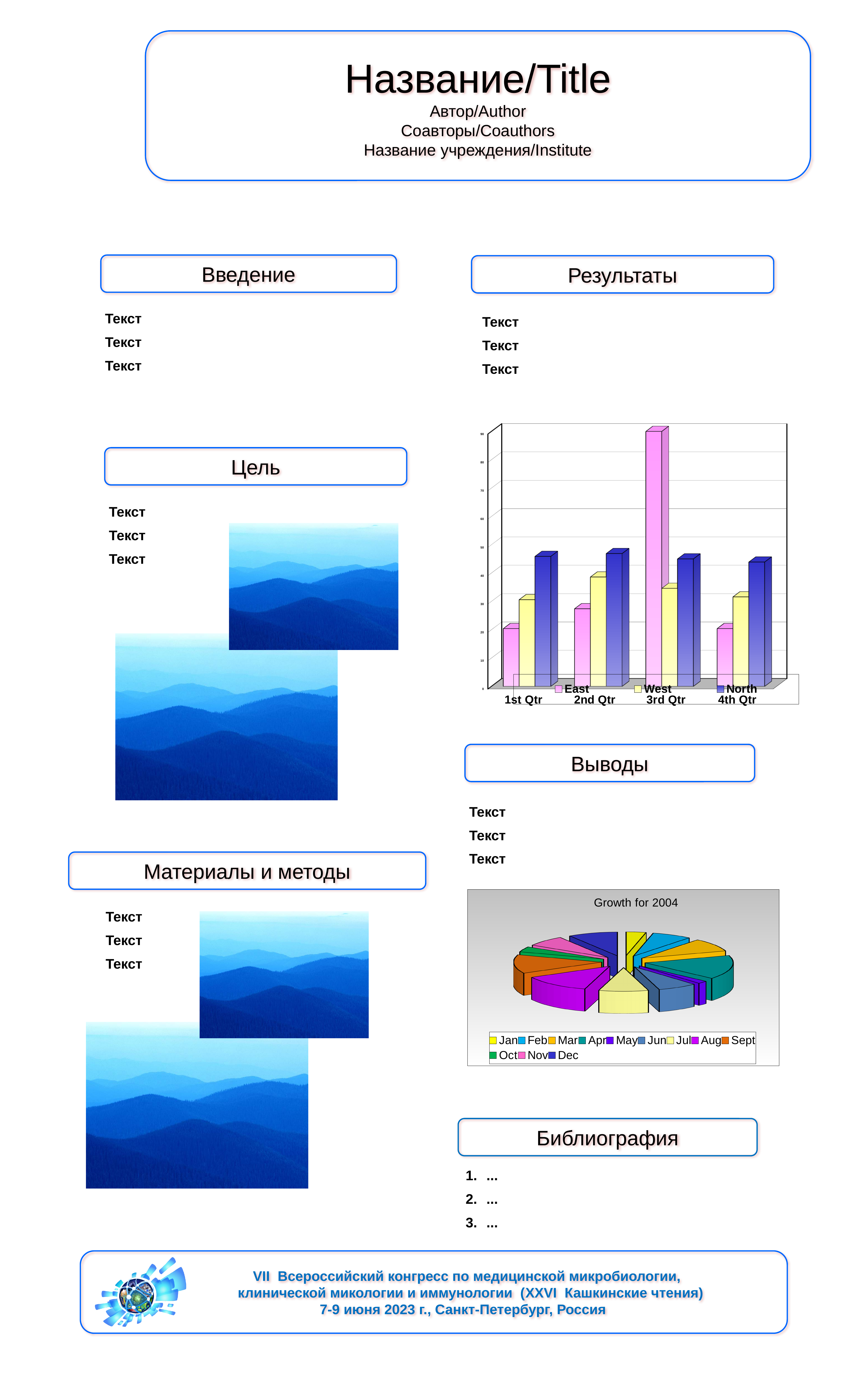
In the chart titled 'Growth for 2004', which slice is larger, Aug or Jan? Aug In the bar chart in the Результаты section, which series has the larger value in 2nd Qtr, West or East? West In the bar chart in the Результаты section, which series has the larger value in 1st Qtr, North or East? North How many entries does the legend of the chart titled 'Growth for 2004' list? 12 In the bar chart in the Результаты section, is the East value for 1st Qtr greater or less than 30? less In the bar chart in the Результаты section, how many quarter categories are shown on the x axis? 4 In the bar chart in the Результаты section, is the East value for 3rd Qtr greater or less than 80? greater What kind of chart is the chart in the Результаты section with 1st Qtr to 4th Qtr on the x axis? bar chart In the bar chart in the Результаты section, which quarter has the highest East value? 3rd Qtr What kind of chart is the chart titled 'Growth for 2004'? pie chart In the bar chart in the Результаты section, how many series does the legend list? 3 In the bar chart in the Результаты section, is the North value for 4th Qtr greater or less than 30? greater